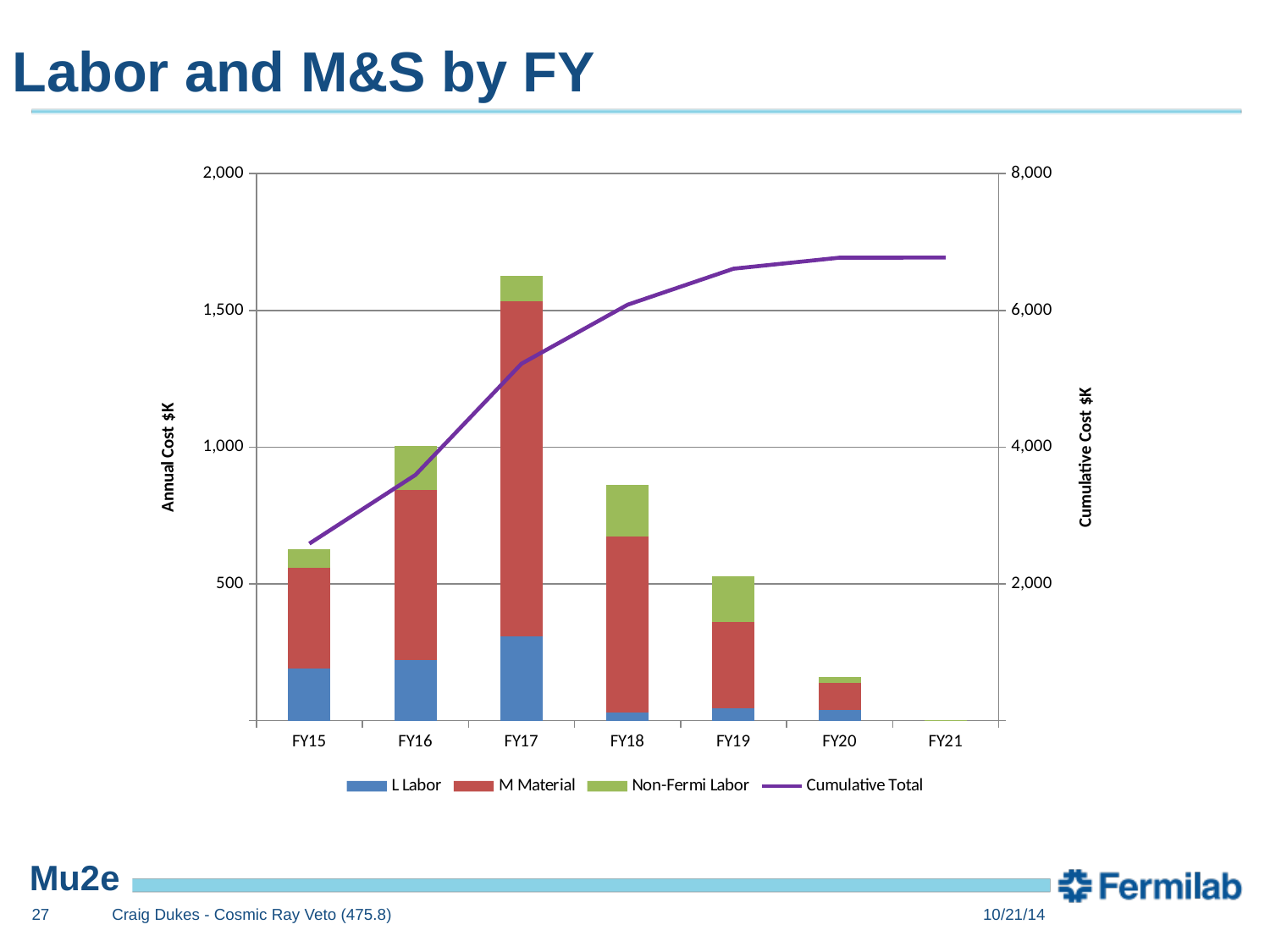
Is the total stacked bar for FY20 greater or less than 500? less What kind of chart is shown on the slide? A stacked bar chart with a line Is the total stacked bar for FY17 greater or less than 1,500? greater How many fiscal years are labelled on the x axis? 7 Which has the larger stacked bar, FY17 or FY18? FY17 What is the title of the right-hand vertical axis? Cumulative Cost $K Which fiscal year with a visible bar has the smallest stacked bar? FY20 Which fiscal year has the tallest stacked bar? FY17 Is the total stacked bar for FY18 greater or less than 1,000? less How many series does the legend list? 4 Does the Cumulative Total line rise or fall from FY15 to FY21? rise